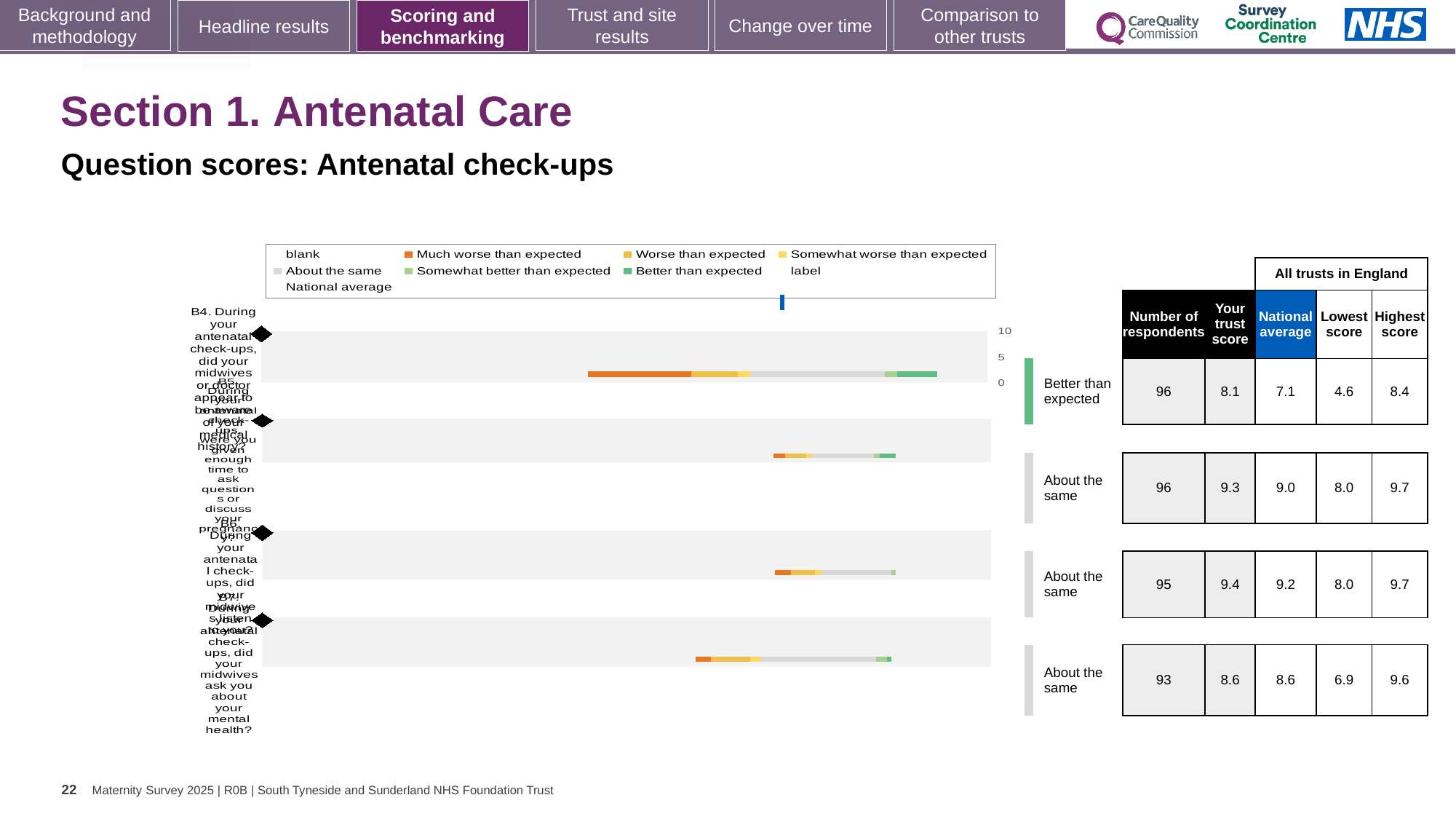
In the table beside the chart, what is the trust score for the first question (B4, midwives or doctor aware of medical history)? 8.1 In the table beside the chart, what is the national average for the first question (B4)? 7.1 Which question has the lowest trust score in the table beside the chart? B4 (aware of medical history) Is the trust score for the third question (B6) larger or smaller than its national average? larger What benchmark category is shown for the first question (B4) in the chart? Better than expected What is the difference between the trust score and the national average for the first question (B4)? 1.0 In the table beside the chart, what is the highest score across all trusts for the second question (B5, enough time to ask questions)? 9.7 How many questions (bars) are plotted in the chart? 4 Which question has the highest trust score in the table beside the chart? B6 (midwives listen to you) In the table beside the chart, what is the number of respondents for the last question (B7, asked about mental health)? 93 What kind of chart is shown on the slide? bar chart What is the lowest score across all trusts for the last question (B7)? 6.9